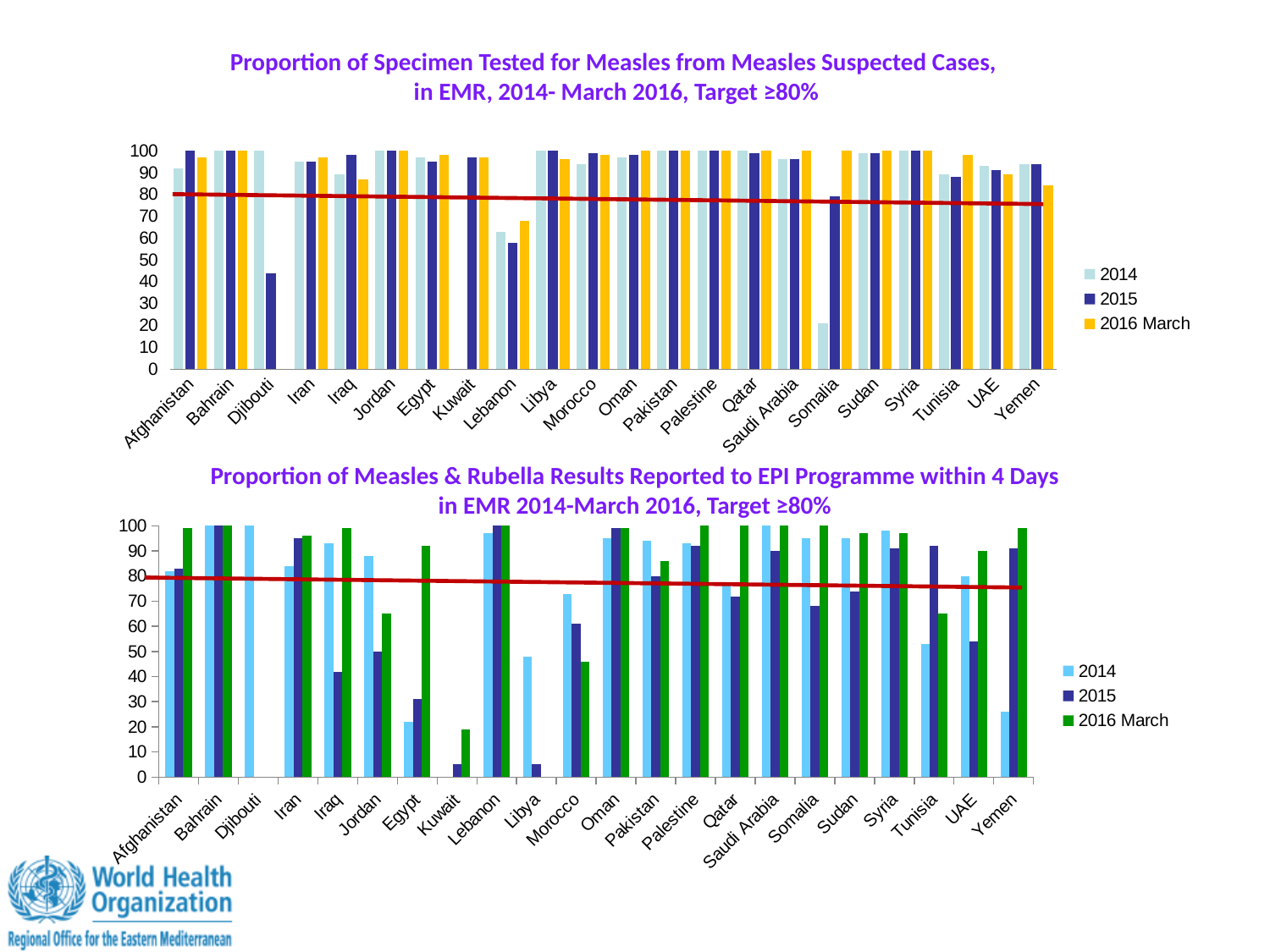
On the top chart (Proportion of Specimen Tested for Measles), is the 2015 value for Lebanon greater or less than 80? less What target value is stated in the title of the bottom chart (Results Reported within 4 Days)? ≥80% On the bottom chart (Results Reported within 4 Days), which country has the lowest 2016 March value? Kuwait What kind of chart is the bottom chart (Proportion of Measles & Rubella Results Reported to EPI Programme within 4 Days)? bar chart On the top chart (Proportion of Specimen Tested for Measles), how many series does the legend list? 3 On the top chart (Proportion of Specimen Tested for Measles), how many countries are shown on the x axis? 22 On the bottom chart (Results Reported within 4 Days), is the 2015 value for Kuwait greater or less than 10? less On the bottom chart (Results Reported within 4 Days), is the 2014 value for Egypt greater or less than 50? less On the top chart (Proportion of Specimen Tested for Measles), which is larger: the 2014 value for Afghanistan or the 2014 value for Lebanon? Afghanistan On the bottom chart (Results Reported within 4 Days), which is larger for Egypt: the 2014 value or the 2016 March value? 2016 March On the top chart (Proportion of Specimen Tested for Measles), which country has the lowest 2014 value? Somalia